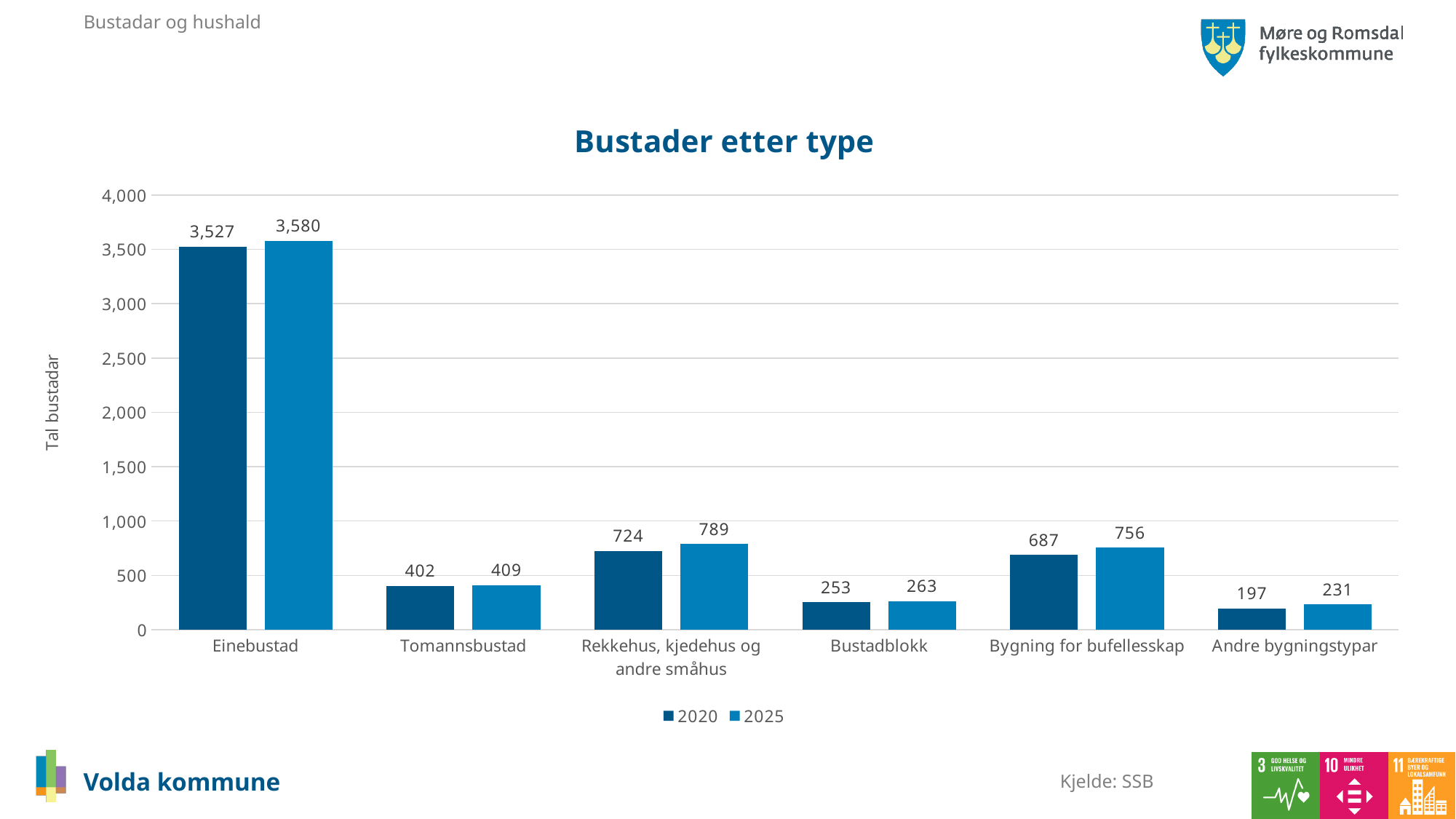
Is the 2025 value for Bygning for bufellesskap greater or less than 1,000? less What is the value for Bustadblokk in 2020? 253 What is the value for Einebustad in 2025? 3,580 What kind of chart is shown? bar chart What is the value for Bygning for bufellesskap in 2025? 756 How many series does the legend list? 2 Which category has the lowest value in 2025? Andre bygningstypar What is the title of the chart? Bustader etter type How many categories are shown on the x axis? 6 Which category has the highest value in 2020? Einebustad What is the difference between the 2025 and 2020 values for Rekkehus, kjedehus og andre småhus? 65 Which is larger: the 2020 value for Tomannsbustad or the 2020 value for Bustadblokk? Tomannsbustad